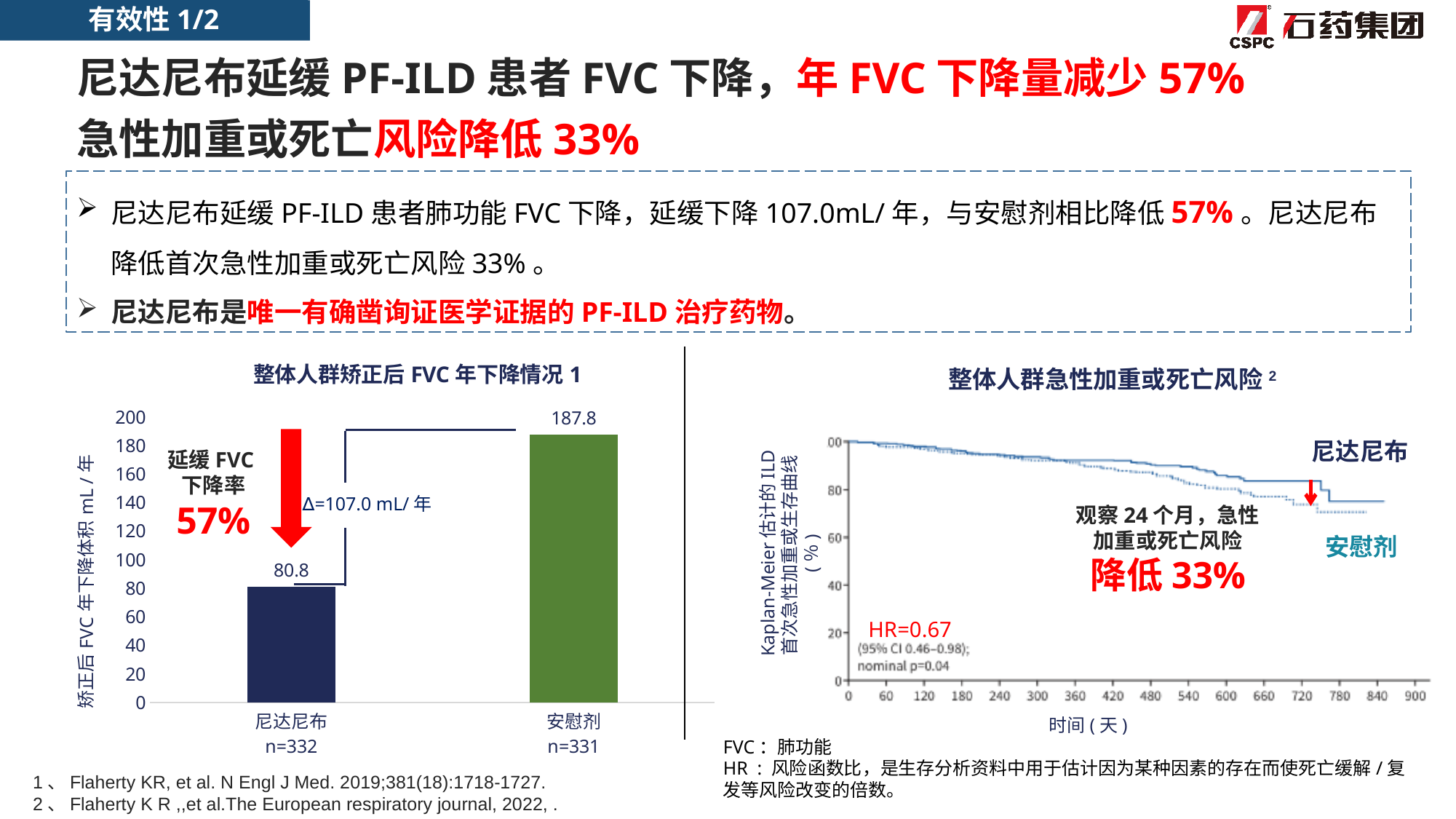
In the bar chart on the left, is the value for 安慰剂 greater or less than 180? greater In the bar chart on the left, which category has the higher value? 安慰剂 In the bar chart on the left, what is the difference between the 安慰剂 value and the 尼达尼布 value? 107.0 In the chart on the right titled 整体人群急性加重或死亡风险, what HR value is shown? HR=0.67 In the bar chart on the left, what is the sample size (n) shown for 尼达尼布? n=332 In the bar chart on the left, which category has the lower value? 尼达尼布 In the bar chart on the left, is the value for 尼达尼布 greater or less than 100? less What kind of chart is the chart on the left of the slide? bar chart In the bar chart titled 整体人群矫正后 FVC 年下降情况, what is the value for 尼达尼布? 80.8 How many bars are shown in the bar chart on the left? 2 In the chart on the right, what is the label of the x axis? 时间 ( 天 ) In the bar chart titled 整体人群矫正后 FVC 年下降情况, what is the value for 安慰剂? 187.8